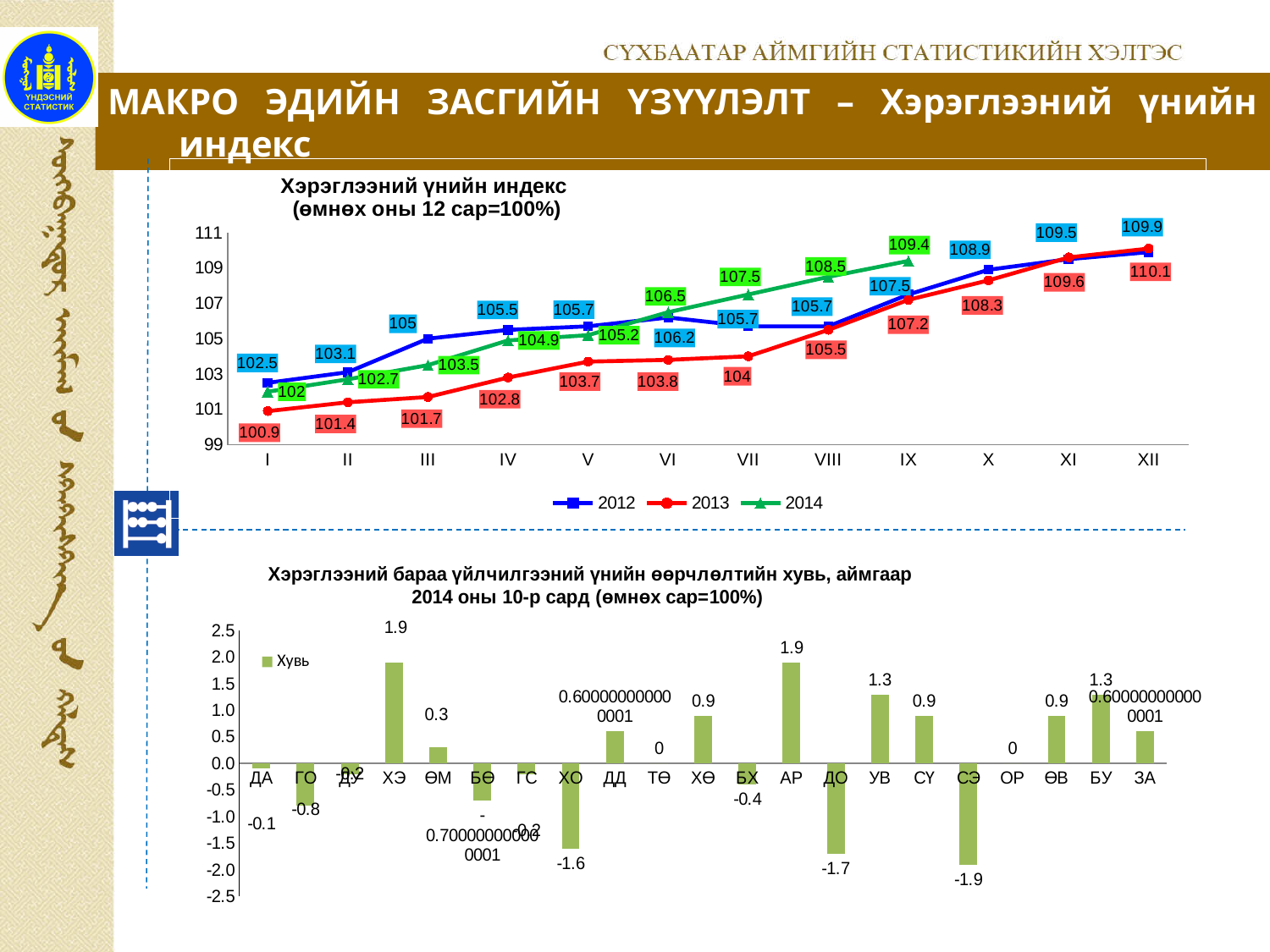
In the bottom chart 'Хэрэглээний бараа үйлчилгээний үнийн өөрчлөлтийн хувь, аймгаар', which is larger, the value for УВ or the value for ХӨ? УВ In the top chart 'Хэрэглээний үнийн индекс', what is the value for 2012 in month X? 108.9 What kind of chart is the bottom chart, 'Хэрэглээний бараа үйлчилгээний үнийн өөрчлөлтийн хувь, аймгаар'? bar chart In the top chart 'Хэрэглээний үнийн индекс', what is the value for 2014 in month IX? 109.4 In the bottom chart 'Хэрэглээний бараа үйлчилгээний үнийн өөрчлөлтийн хувь, аймгаар', what is the value for ДО? -1.7 In the top chart 'Хэрэглээний үнийн индекс', does the 2013 series rise or fall from month I to month XII? rise In the top chart 'Хэрэглээний үнийн индекс', what is the value for 2013 in month I? 100.9 In the top chart 'Хэрэглээний үнийн индекс', what is the difference between the 2013 and 2012 values in month XII? 0.2 In the top chart 'Хэрэглээний үнийн индекс', how many months are shown on the x axis? 12 In the bottom chart 'Хэрэглээний бараа үйлчилгээний үнийн өөрчлөлтийн хувь, аймгаар', which category has the lowest value? СЭ What kind of chart is the top chart, 'Хэрэглээний үнийн индекс'? line chart In the top chart 'Хэрэглээний үнийн индекс', how many series does the legend list? 3